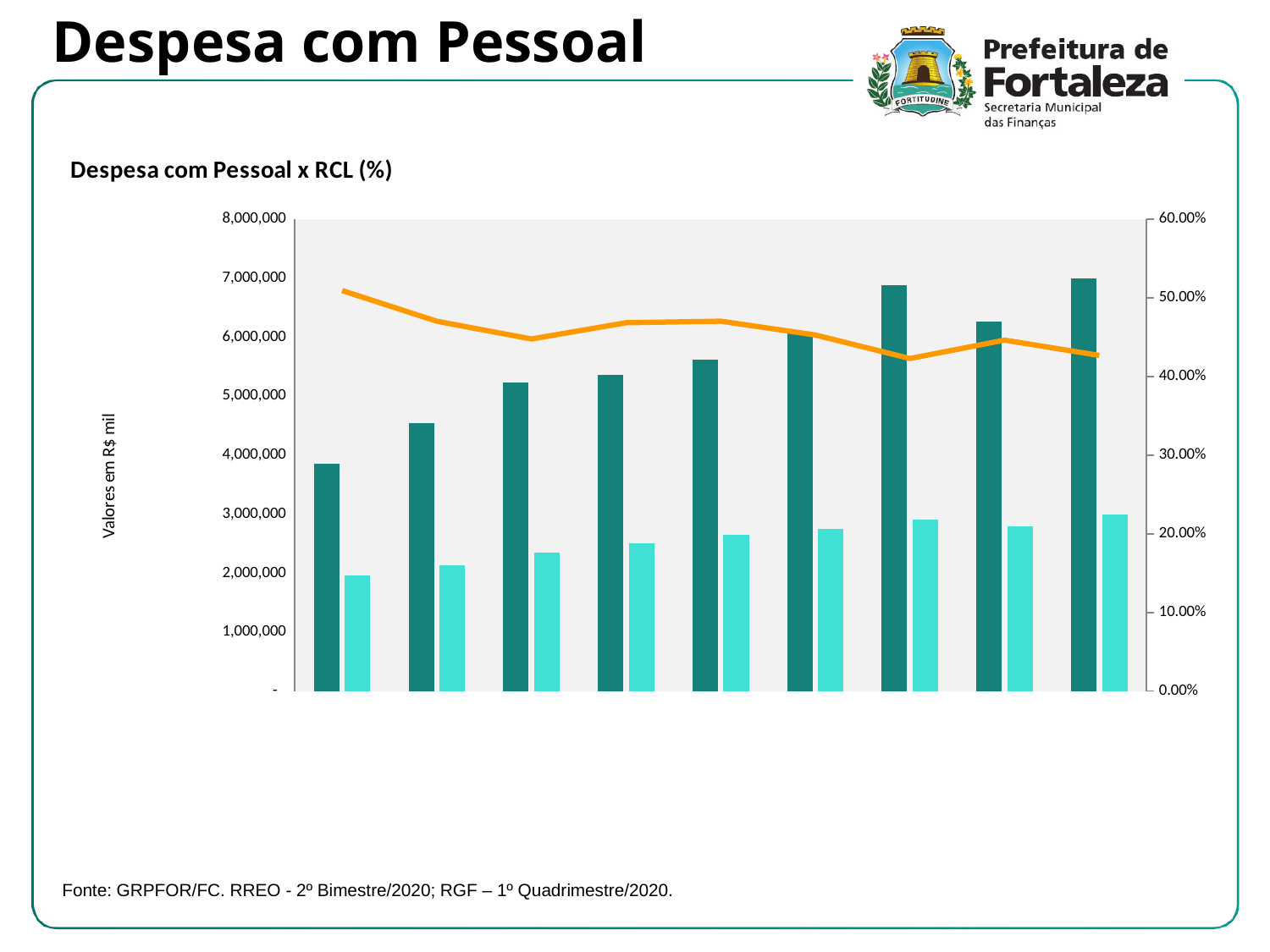
What is the title of the chart? Despesa com Pessoal x RCL (%) Which dark green bar is the shortest? the leftmost one Is the value of the rightmost light blue bar greater or less than 2,000,000? greater Does the orange line generally rise or fall from left to right? fall On the right-hand percentage axis, is the rightmost point of the orange line greater or less than 50.00%? less Is the value of the rightmost dark green bar greater or less than 6,000,000? greater Do the dark green bars generally rise or fall from left to right? rise How many groups of bars are plotted in the chart? 9 What is the title of the left vertical axis? Valores em R$ mil What kind of chart is shown on the slide? bar chart with a line